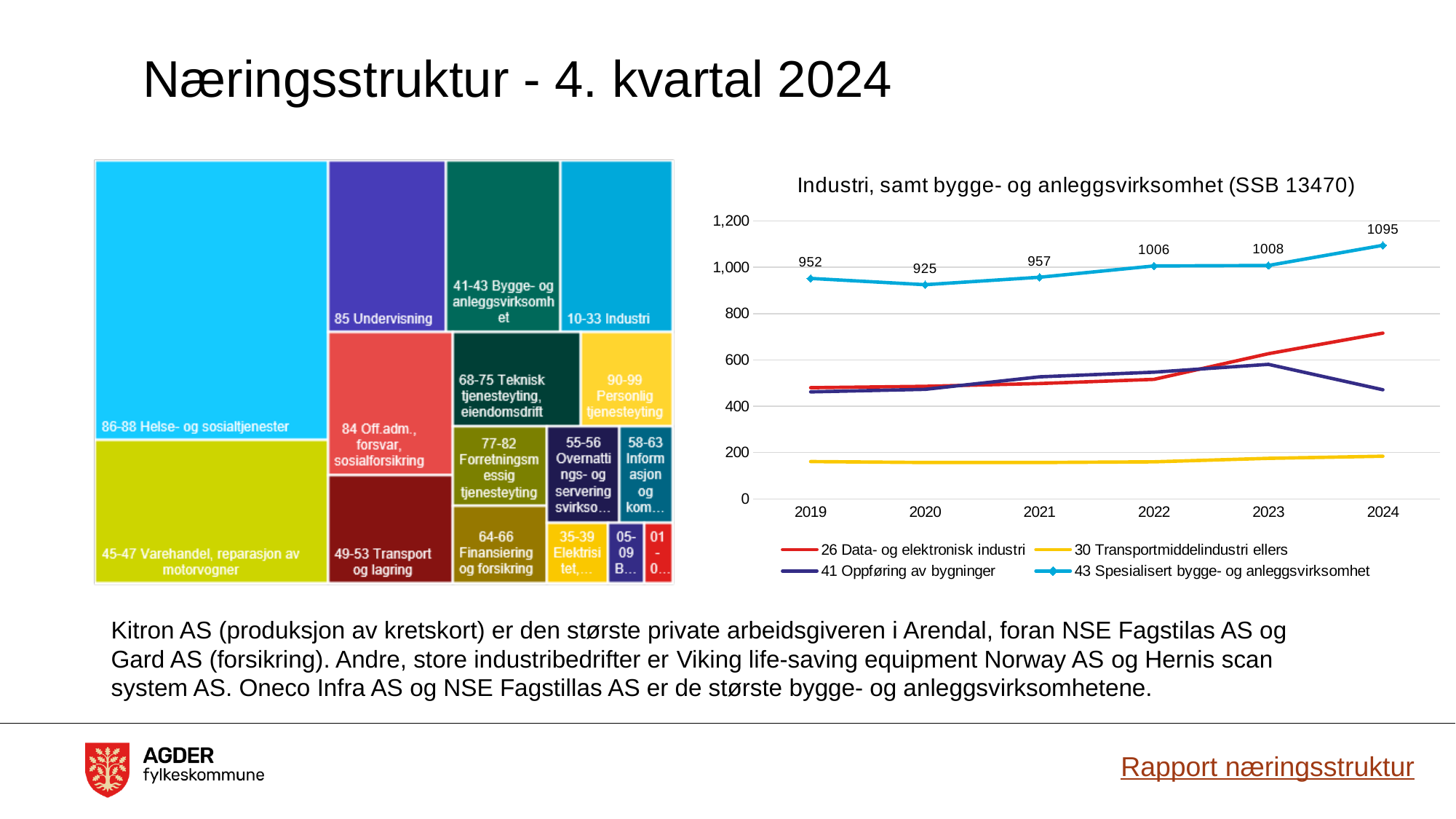
In the chart 'Industri, samt bygge- og anleggsvirksomhet (SSB 13470)', is the value for 26 Data- og elektronisk industri in 2024 greater or less than 600? greater In the chart 'Industri, samt bygge- og anleggsvirksomhet (SSB 13470)', in which year is 43 Spesialisert bygge- og anleggsvirksomhet lowest? 2020 In the chart 'Industri, samt bygge- og anleggsvirksomhet (SSB 13470)', how many years are shown on the x axis? 6 In the chart 'Industri, samt bygge- og anleggsvirksomhet (SSB 13470)', in which year is 43 Spesialisert bygge- og anleggsvirksomhet highest? 2024 In the chart 'Industri, samt bygge- og anleggsvirksomhet (SSB 13470)', what is the value for 43 Spesialisert bygge- og anleggsvirksomhet in 2024? 1095 In the chart 'Industri, samt bygge- og anleggsvirksomhet (SSB 13470)', is the value for 30 Transportmiddelindustri ellers in 2019 greater or less than 200? less In the chart 'Industri, samt bygge- og anleggsvirksomhet (SSB 13470)', does 41 Oppføring av bygninger rise or fall from 2023 to 2024? fall In the chart 'Industri, samt bygge- og anleggsvirksomhet (SSB 13470)', how much higher is 43 Spesialisert bygge- og anleggsvirksomhet in 2024 than in 2019? 143 What kind of chart is 'Industri, samt bygge- og anleggsvirksomhet (SSB 13470)'? line chart In the chart 'Industri, samt bygge- og anleggsvirksomhet (SSB 13470)', what is the difference between the 2022 and 2021 values for 43 Spesialisert bygge- og anleggsvirksomhet? 49 In the chart 'Industri, samt bygge- og anleggsvirksomhet (SSB 13470)', what is the value for 43 Spesialisert bygge- og anleggsvirksomhet in 2020? 925 In the chart 'Industri, samt bygge- og anleggsvirksomhet (SSB 13470)', how many series does the legend list? 4